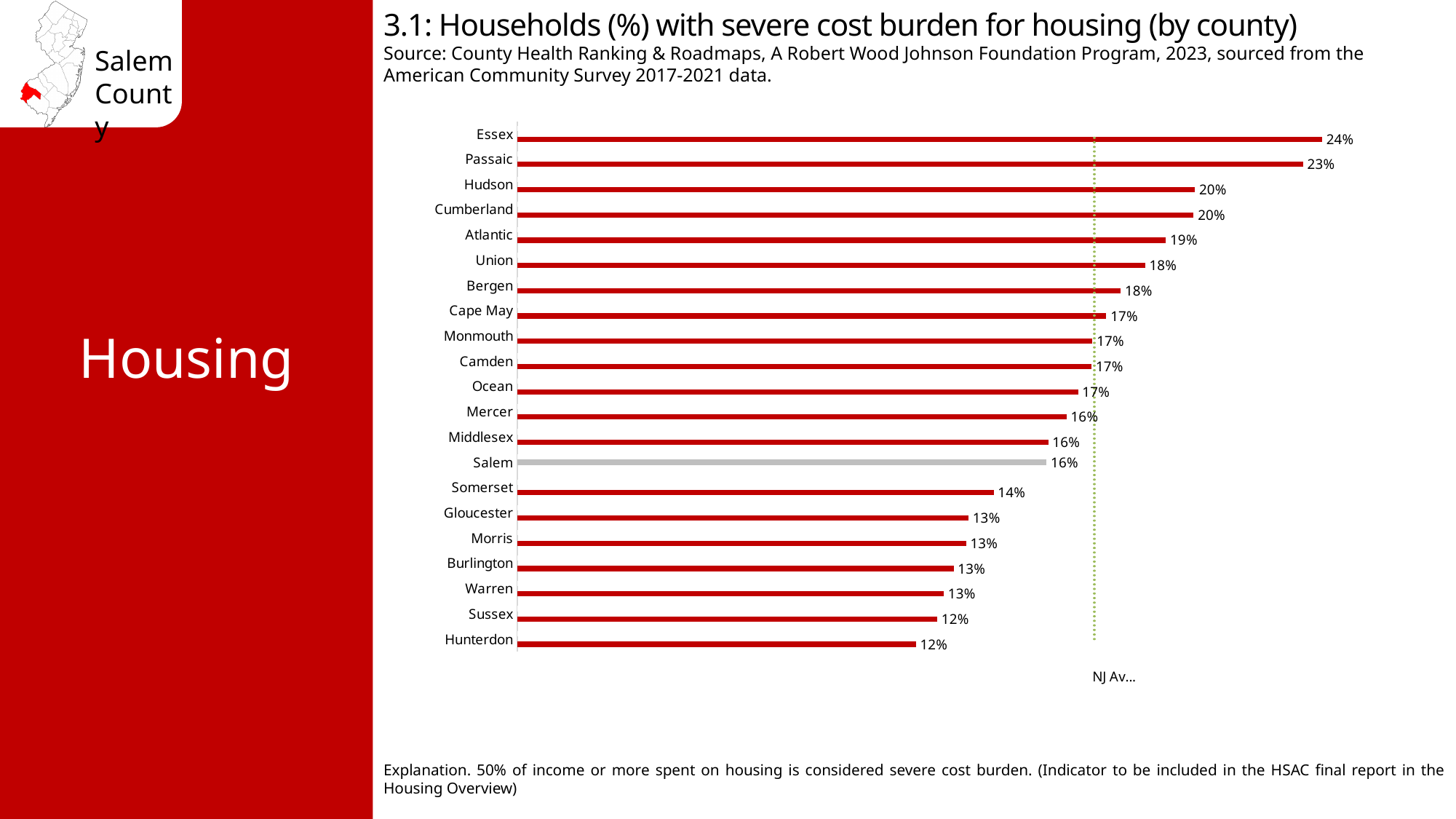
What is the difference between the values for Essex and Salem? 8 percentage points What is the value shown for Somerset County? 14% What is the value shown for Hunterdon County? 12% What is the difference between the values for Passaic and Hunterdon? 11 percentage points What is the value shown for Essex County? 24% Which has a higher value, Atlantic or Gloucester? Atlantic What is the lowest value shown on the chart? 12% What percentage of households in Salem County have a severe cost burden for housing? 16% Which county has the highest percentage of households with severe housing cost burden? Essex Which county's bar is shown in grey instead of red? Salem What kind of chart is shown on the slide? Bar chart How many counties are shown on the chart? 21